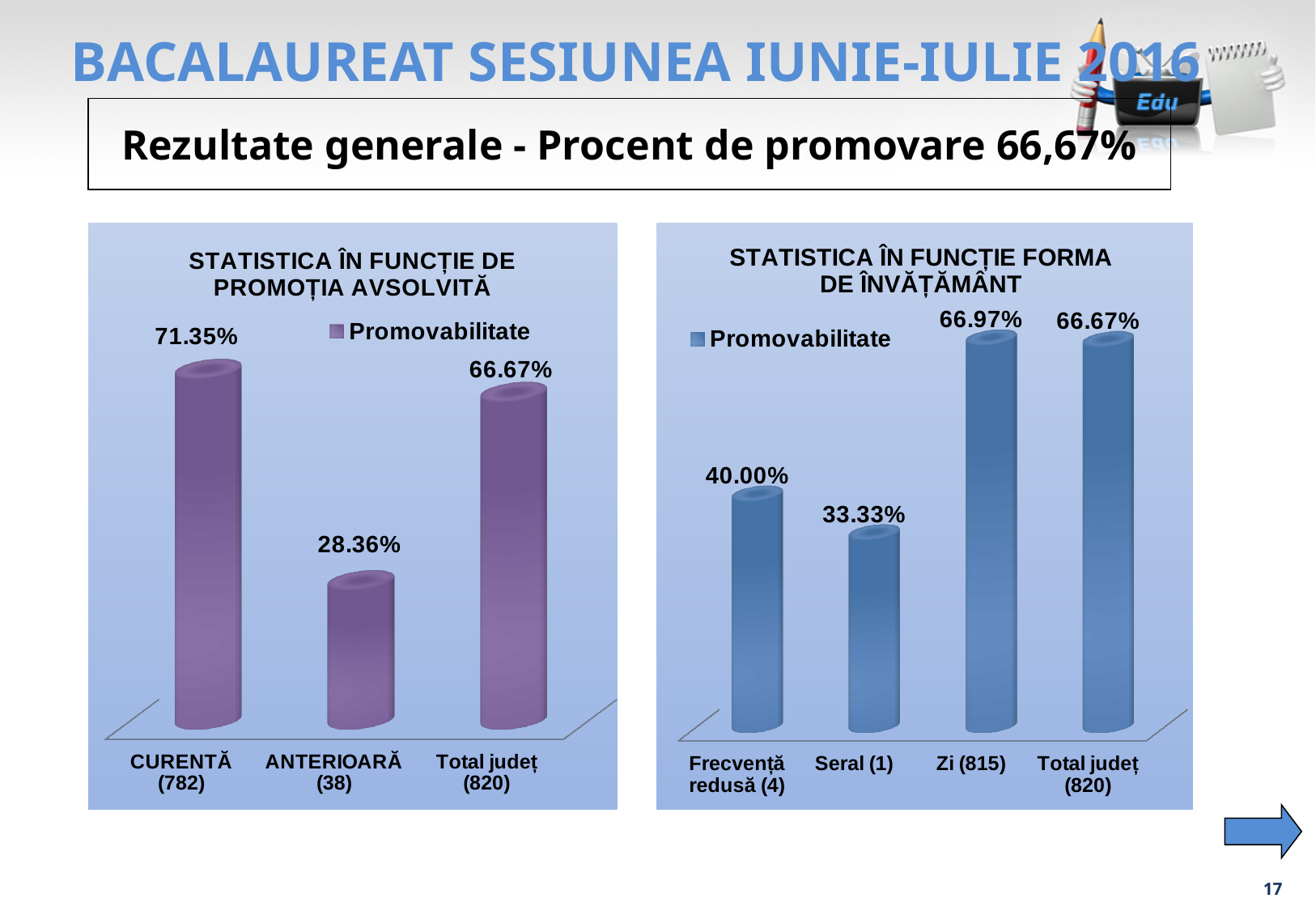
In the right chart (STATISTICA ÎN FUNCȚIE FORMA DE ÎNVĂȚĂMÂNT), what is the value for Seral (1)? 33.33% In the left chart (STATISTICA ÎN FUNCȚIE DE PROMOȚIA AVSOLVITĂ), what is the difference between the values for CURENTĂ (782) and ANTERIOARĂ (38)? 42.99% In the right chart (STATISTICA ÎN FUNCȚIE FORMA DE ÎNVĂȚĂMÂNT), what is the value for Zi (815)? 66.97% In the right chart (STATISTICA ÎN FUNCȚIE FORMA DE ÎNVĂȚĂMÂNT), what is the difference between the values for Zi (815) and Total județ (820)? 0.30% In the right chart (STATISTICA ÎN FUNCȚIE FORMA DE ÎNVĂȚĂMÂNT), how many categories are shown? 4 In the left chart (STATISTICA ÎN FUNCȚIE DE PROMOȚIA AVSOLVITĂ), what is the value for ANTERIOARĂ (38)? 28.36% In the right chart (STATISTICA ÎN FUNCȚIE FORMA DE ÎNVĂȚĂMÂNT), which is larger: the value for Frecvență redusă (4) or Seral (1)? Frecvență redusă (4) In the left chart (STATISTICA ÎN FUNCȚIE DE PROMOȚIA AVSOLVITĂ), what is the Promovabilitate value for CURENTĂ (782)? 71.35% What kind of chart is the right chart (STATISTICA ÎN FUNCȚIE FORMA DE ÎNVĂȚĂMÂNT)? Bar chart In the left chart (STATISTICA ÎN FUNCȚIE DE PROMOȚIA AVSOLVITĂ), which category has the lowest value? ANTERIOARĂ (38) In the left chart (STATISTICA ÎN FUNCȚIE DE PROMOȚIA AVSOLVITĂ), how many categories are shown? 3 In the right chart (STATISTICA ÎN FUNCȚIE FORMA DE ÎNVĂȚĂMÂNT), which category has the highest value? Zi (815)